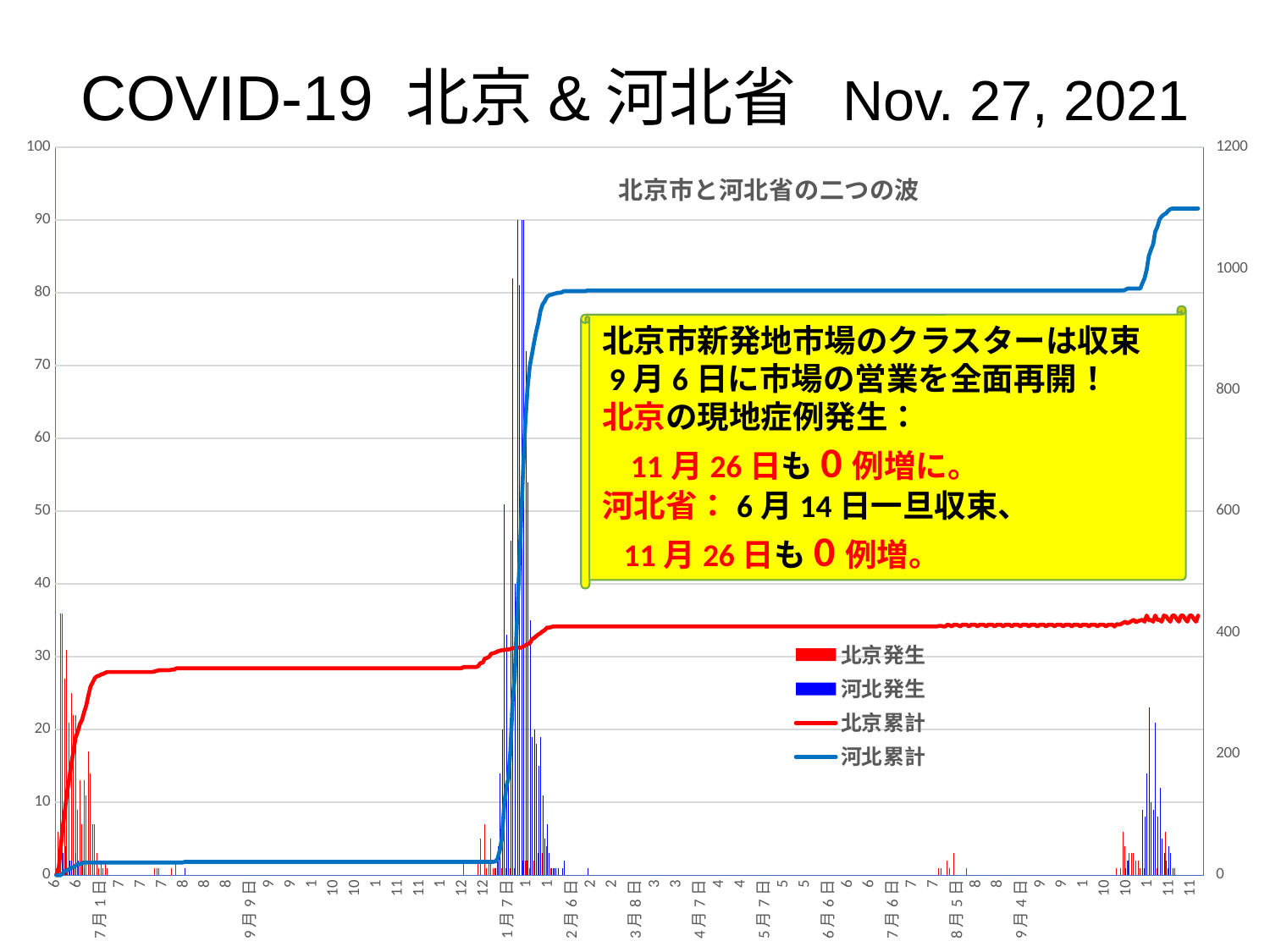
What kind of chart is shown on the slide? A combined bar and line chart Which cumulative line, 北京累計 or 河北累計, is higher at the right end of the chart? 河北累計 Is the final value of the 北京累計 line greater or less than 600 on the right-hand axis? less What is the title printed inside the chart area? 北京市と河北省の二つの波 How many series does the chart legend list? 4 Which colour is used for the 河北累計 series in the legend? Blue Which series shows the highest cumulative value at the end of the period? 河北累計 What is the maximum value shown on the left-hand vertical axis? 100 Does the 河北累計 line rise or fall overall from left to right? Rise Is the final value of the 河北累計 line greater or less than 1000 on the right-hand axis? greater